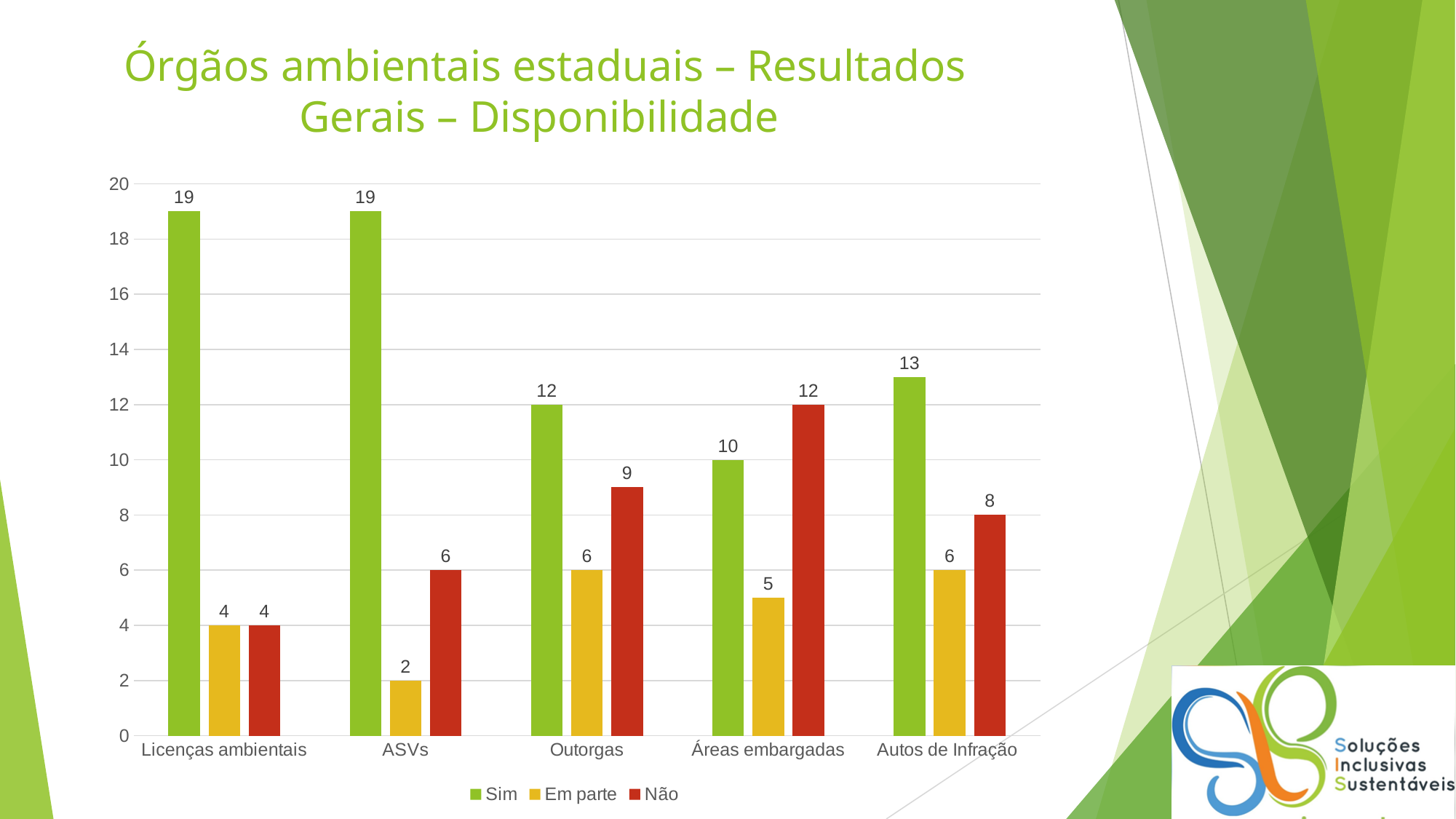
What is the difference between the "Sim" and "Não" values for Autos de Infração? 5 Which category has the lowest "Sim" value? Áreas embargadas What is the value of "Não" for Áreas embargadas? 12 How many series does the legend list? 3 What is the value of "Em parte" for ASVs? 2 Which colour represents the "Em parte" series? Yellow What kind of chart is shown on the slide? Bar chart What is the value of "Sim" for Outorgas? 12 How many categories are shown on the x axis? 5 Which category has the highest "Não" value? Áreas embargadas Which is larger for Outorgas: "Em parte" or "Não"? Não What is the total of the three values for Licenças ambientais? 27